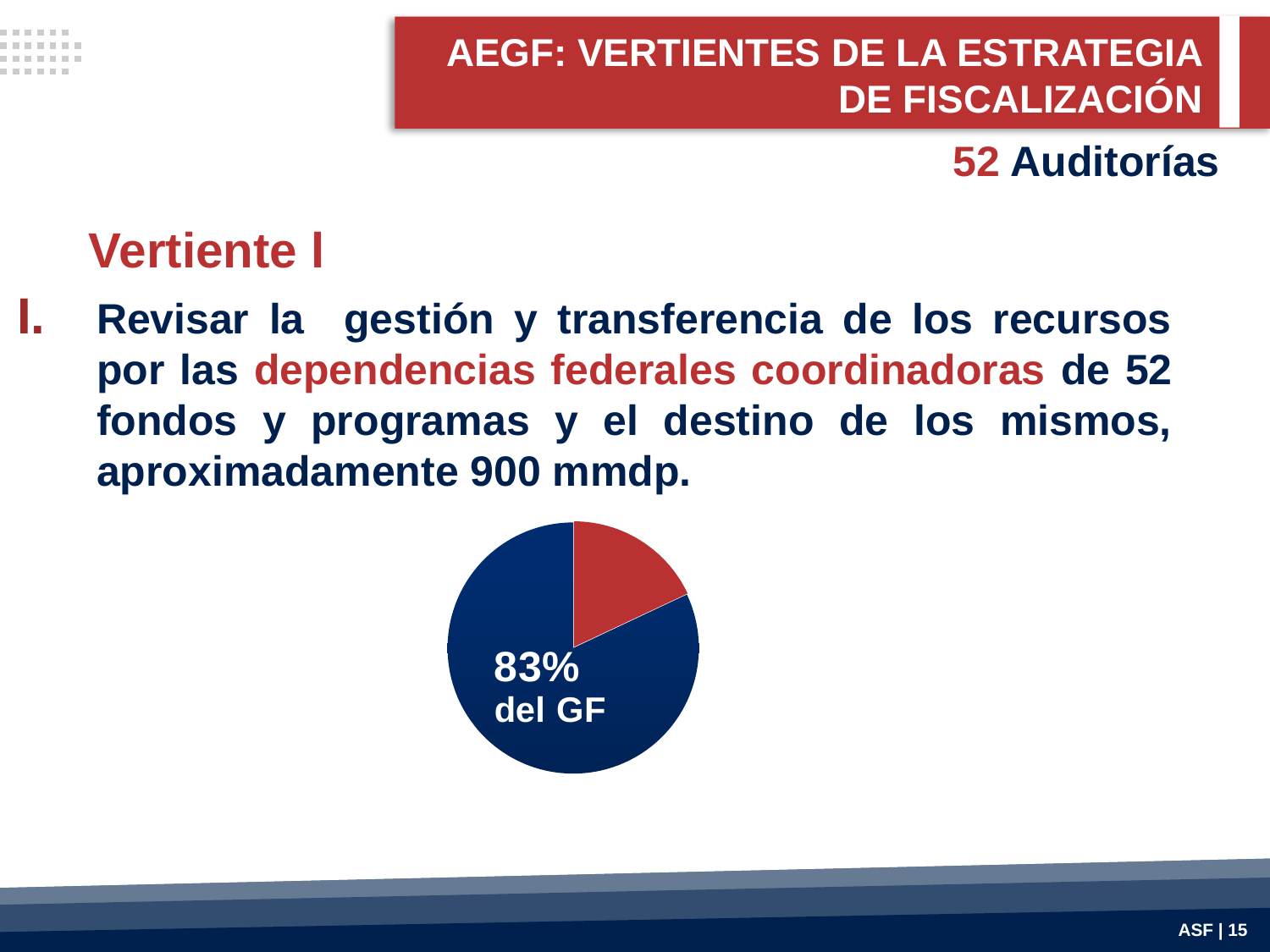
Is the share of the dark blue slice greater or less than 50%? greater What kind of chart is shown on the slide? pie chart What text label is printed inside the pie chart? 83% del GF What colour is the smaller slice of the pie chart? red Which slice is the largest in the pie chart? the dark blue slice (83% del GF) Which slice of the pie chart is larger, the dark blue one or the red one? the dark blue one What percentage is printed on the dark blue slice of the pie chart? 83% What share of the pie does the slice labelled "del GF" represent? 83% How many slices does the pie chart have? 2